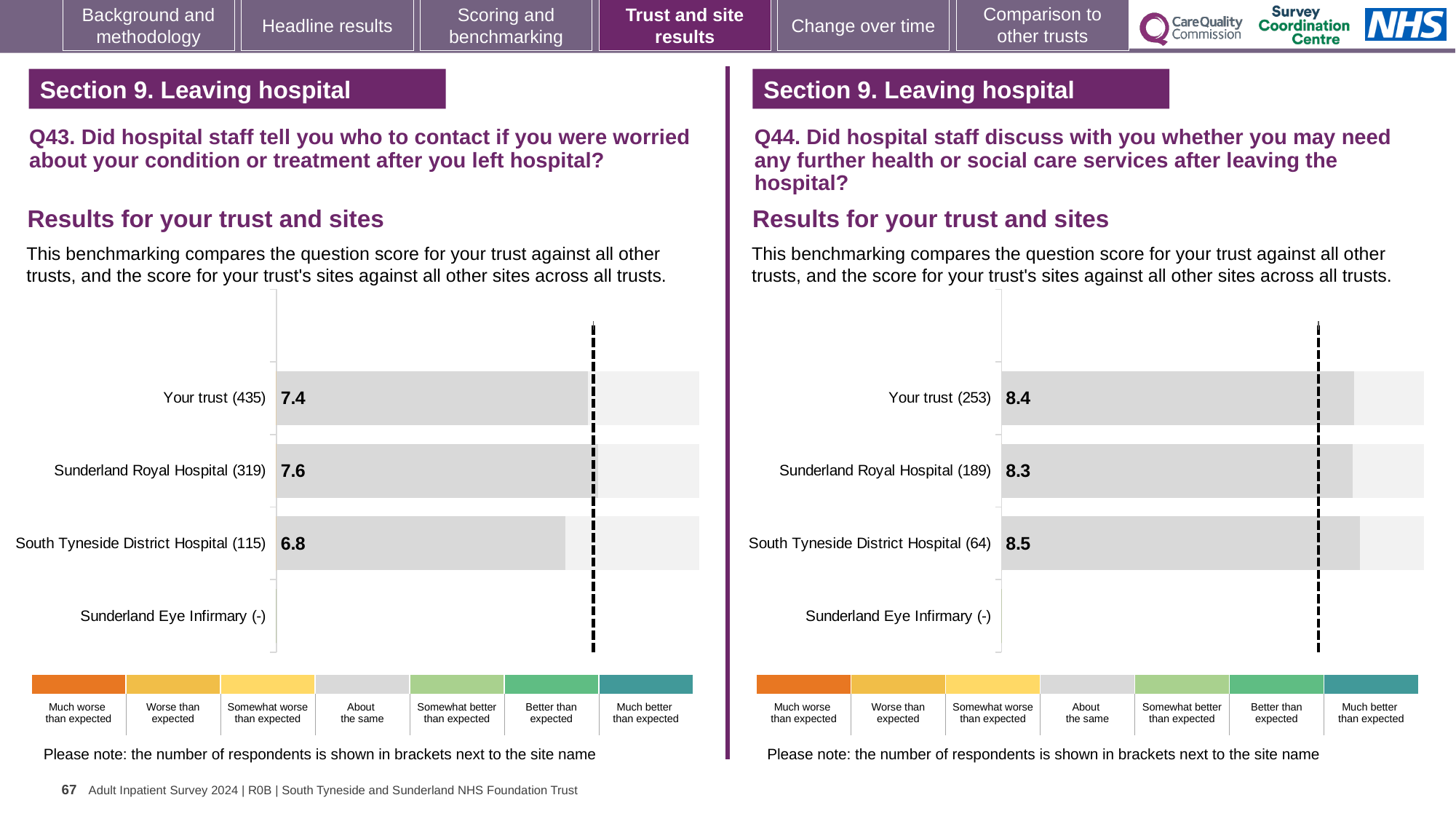
What kind of chart is used on the left for Q43? Bar chart In the Q44 chart on the right, which site has the highest score? South Tyneside District Hospital In the Q44 chart on the right, how many respondents are shown for Sunderland Royal Hospital? 189 In the Q43 chart on the left, what is the score for Sunderland Royal Hospital? 7.6 How many categories are listed on the y axis of the Q43 chart on the left? 4 In the Q43 chart on the left, what is the difference between the scores for Sunderland Royal Hospital and South Tyneside District Hospital? 0.8 In the Q43 chart on the left, what is the score for Your trust? 7.4 In the Q43 chart on the left, what is the score for South Tyneside District Hospital? 6.8 In the Q44 chart on the right, which is larger: the score for Your trust or for Sunderland Royal Hospital? Your trust In the Q44 chart on the right, what is the score for South Tyneside District Hospital? 8.5 In the Q44 chart on the right, what is the score for Your trust? 8.4 In the Q43 chart on the left, which site has the lowest score? South Tyneside District Hospital